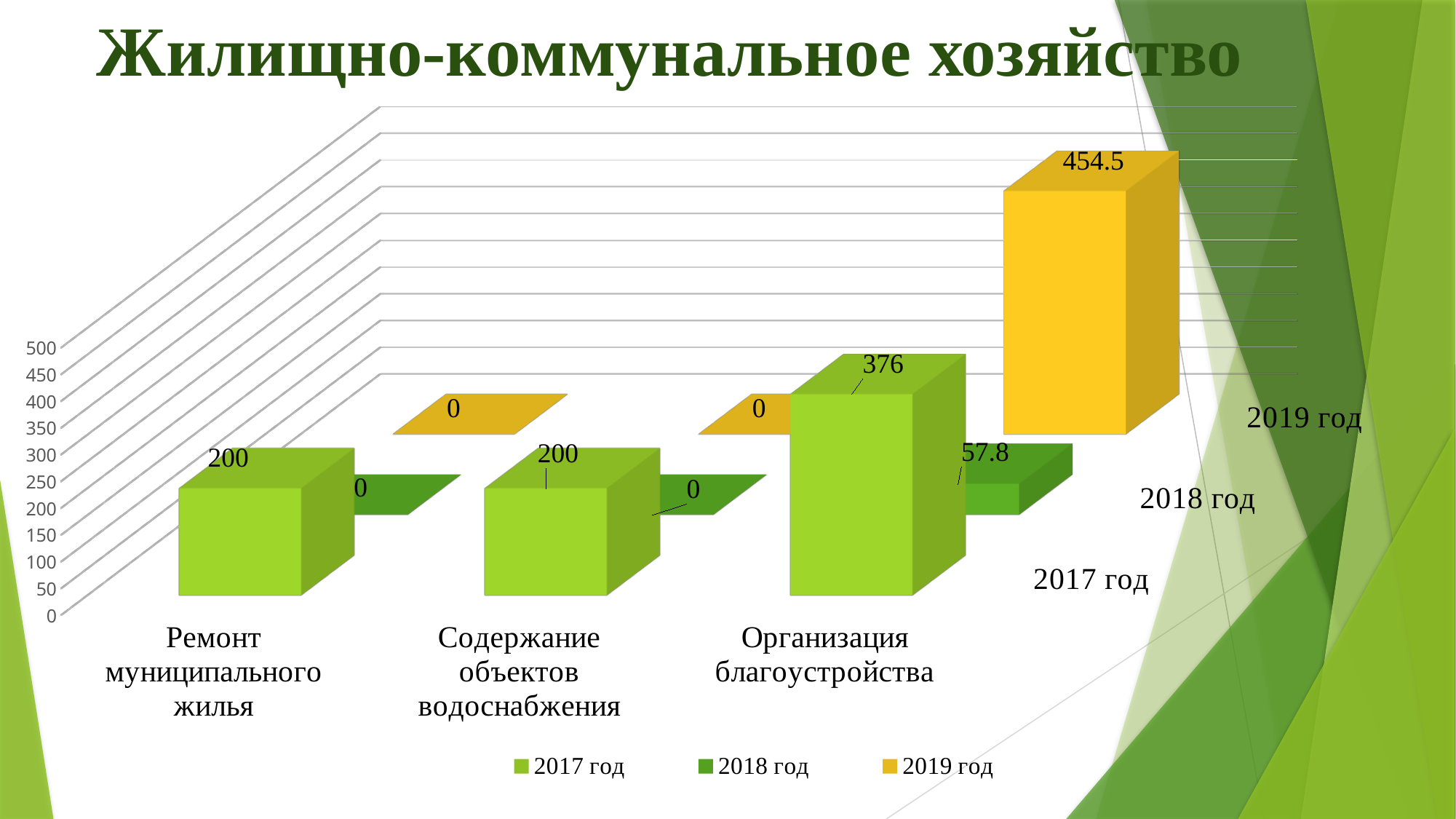
What is the value for Организация благоустройства in the 2019 год series? 454.5 What is the value for Ремонт муниципального жилья in the 2017 год series? 200 How many categories are shown on the x axis? 3 How many series does the legend list? 3 Which is larger for Организация благоустройства: the 2018 год value or the 2019 год value? 2019 год What is the value for Организация благоустройства in the 2018 год series? 57.8 What is the difference between the 2017 год values for Организация благоустройства and Ремонт муниципального жилья? 176 What is the value for Организация благоустройства in the 2017 год series? 376 Which category has the highest value in the 2017 год series? Организация благоустройства What is the difference between the 2019 год and 2017 год values for Организация благоустройства? 78.5 What kind of chart is shown on the slide? Bar chart What is the value for Содержание объектов водоснабжения in the 2019 год series? 0